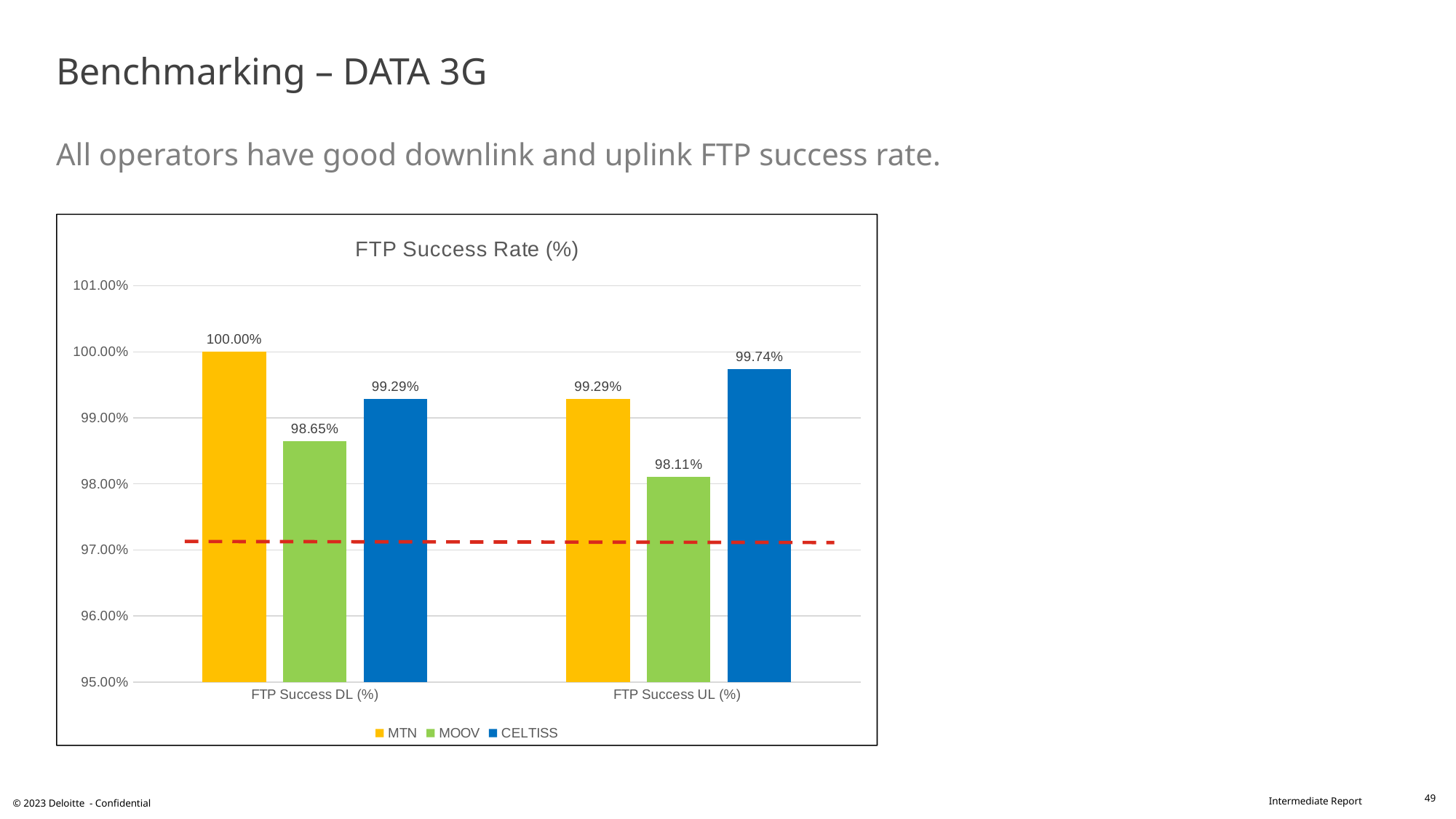
What kind of chart is shown on the slide? Bar chart How many series does the legend list? 3 What is the FTP Success UL (%) value for CELTISS? 99.74% What is the FTP Success UL (%) value for MOOV? 98.11% What is the difference between MTN's and MOOV's FTP Success DL (%) values? 1.35% What is the FTP Success DL (%) value for MTN? 100.00% Which operator has the lowest FTP Success UL (%)? MOOV Which operator has the highest FTP Success DL (%)? MTN How many categories are shown on the x axis? 2 Is the FTP Success DL (%) value for MOOV greater or less than 99.00%? less Which is larger: CELTISS's FTP Success UL (%) or MTN's FTP Success UL (%)? CELTISS What is the title of the chart? FTP Success Rate (%)